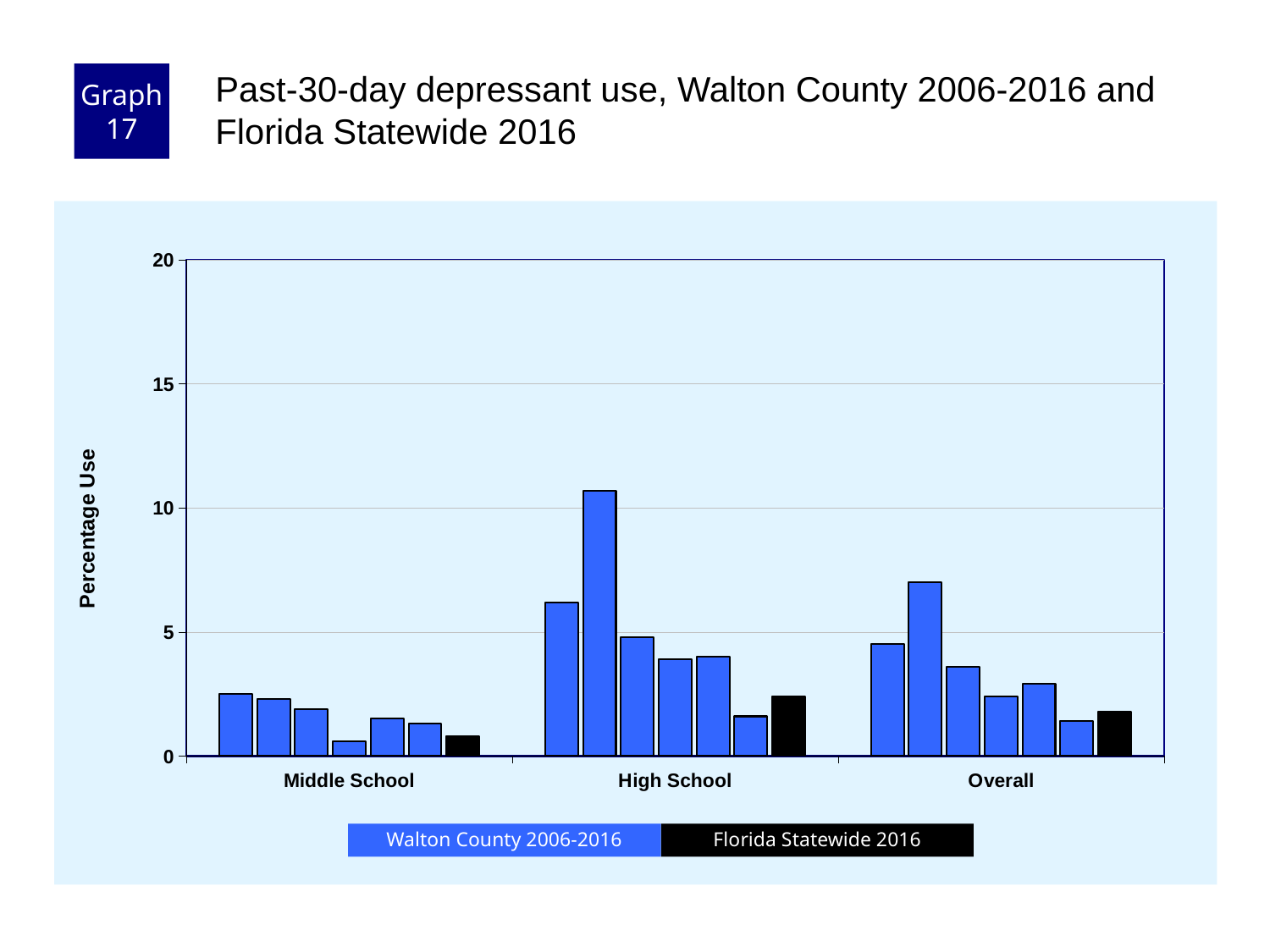
What colour represents Florida Statewide 2016 in the chart? black Which category contains the tallest bar in the chart? High School How many categories are shown on the x axis of the chart? 3 What is the label on the y axis of the chart? Percentage Use What kind of chart is shown on the slide? bar chart Is the tallest Walton County 2006-2016 bar in the Overall category greater or less than 5? greater Is the Florida Statewide 2016 value for High School greater or less than 5? less Is the tallest Walton County 2006-2016 bar in the Middle School category greater or less than 5? less Which category contains the lowest bars overall in the chart? Middle School How many series does the chart's legend list? 2 Which is larger, the Florida Statewide 2016 value for High School or for Middle School? High School